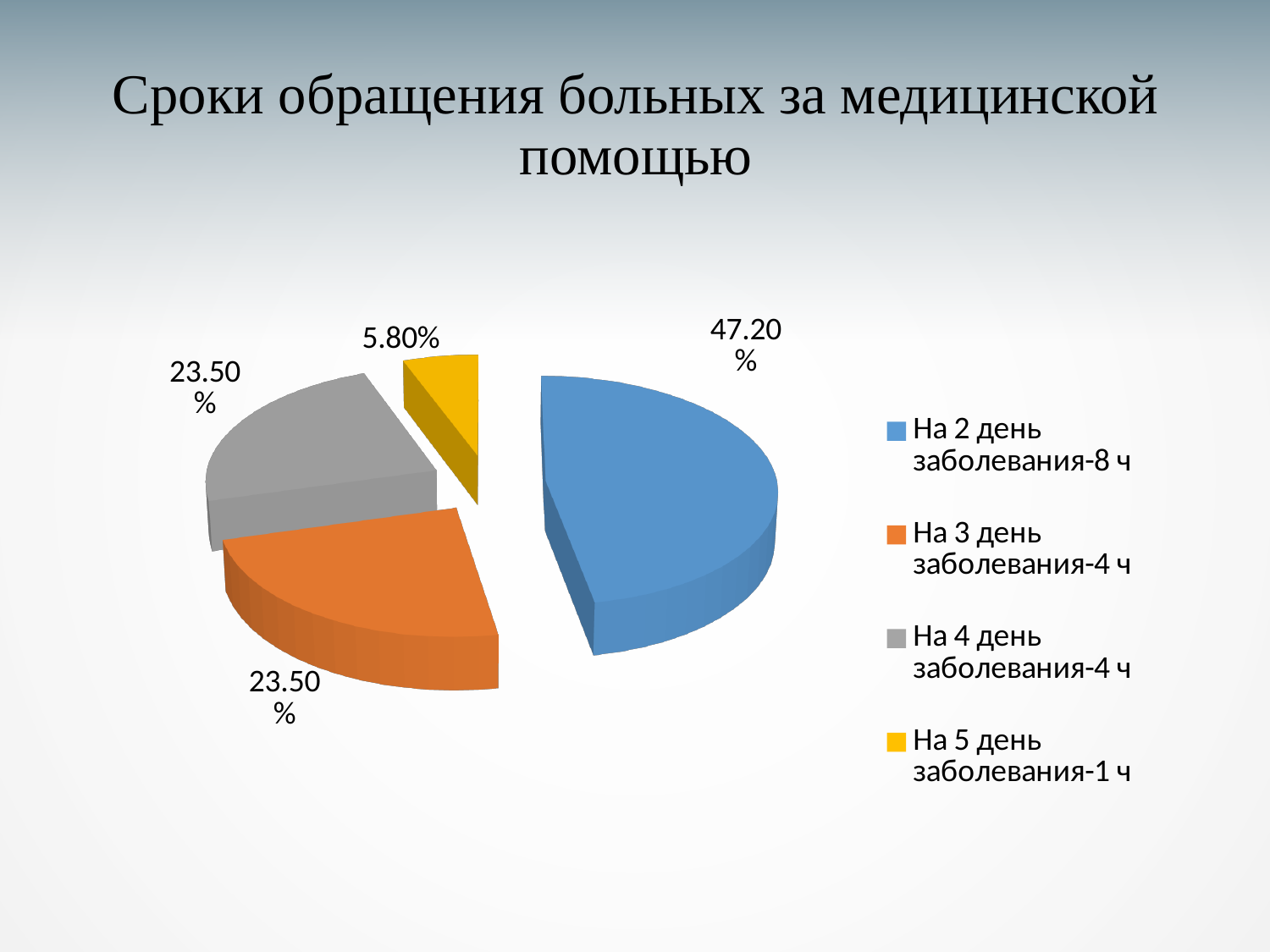
What value is labelled on the slice for 'На 3 день заболевания-4 ч'? 23.50% What is the difference in percentage points between the 'На 2 день заболевания-8 ч' slice and the 'На 5 день заболевания-1 ч' slice? 41.40% What percentage is shown for the slice 'На 5 день заболевания-1 ч'? 5.80% What share of patients sought medical help on the 2nd day of illness (На 2 день заболевания-8 ч)? 47.20% How many slices does the pie chart have? 4 How much larger is the 'На 2 день заболевания-8 ч' share than the 'На 4 день заболевания-4 ч' share? 23.70% Which category has the smallest slice of the pie? На 5 день заболевания-1 ч What type of chart is shown on the slide? Pie chart What is the title of the slide containing the chart? Сроки обращения больных за медицинской помощью Which is larger: the share for 'На 4 день заболевания-4 ч' or the share for 'На 5 день заболевания-1 ч'? На 4 день заболевания-4 ч What colour is the slice representing 'На 3 день заболевания-4 ч'? Orange Which category has the largest slice of the pie? На 2 день заболевания-8 ч